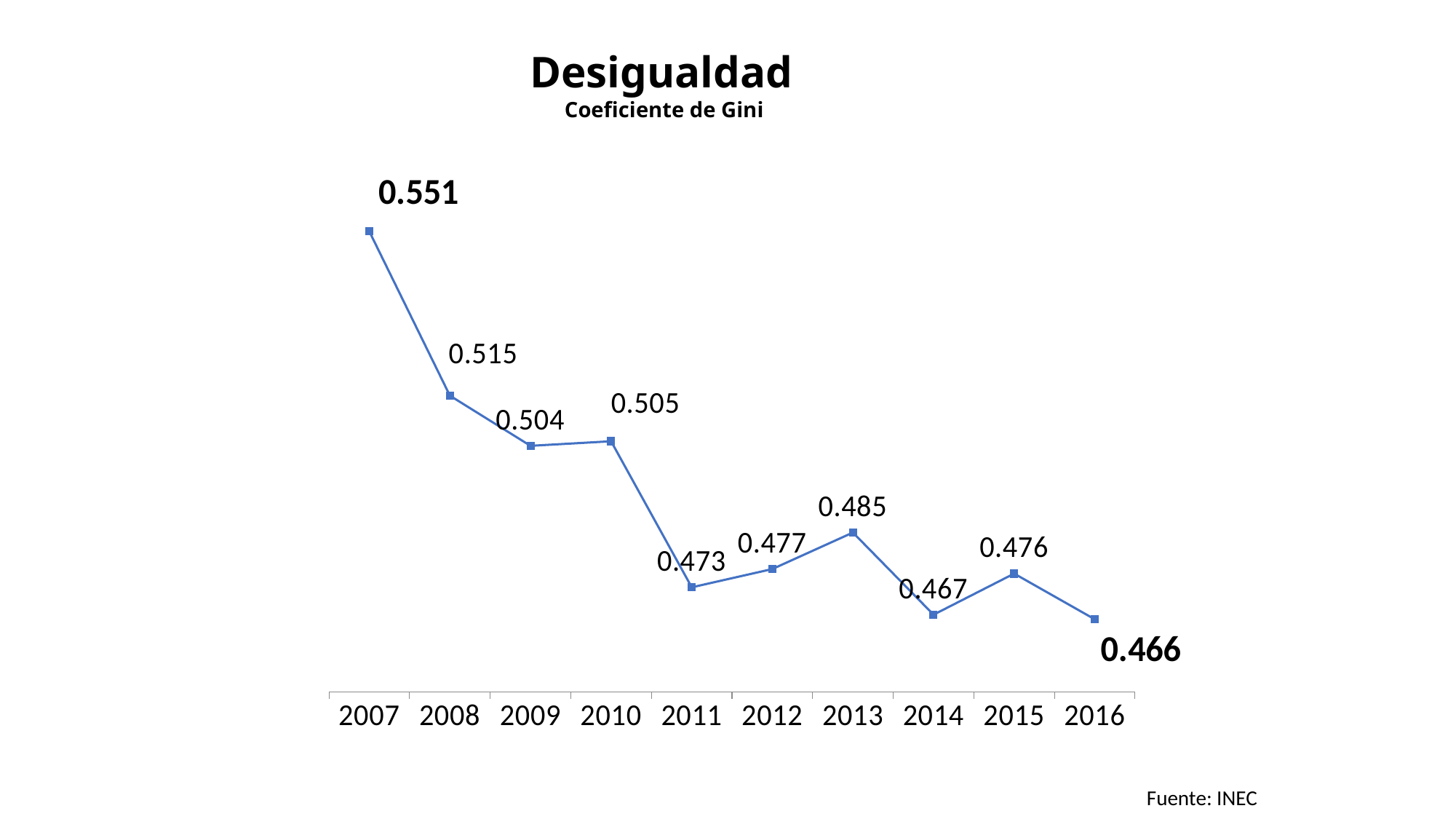
Which year has a higher Gini coefficient, 2008 or 2010? 2008 What is the Gini coefficient value for 2013? 0.485 What is the difference between the Gini coefficient in 2007 and in 2016? 0.085 What is the Gini coefficient value for 2011? 0.473 Which year has the lowest Gini coefficient? 2016 What kind of chart is shown on the slide? Line chart How many years are plotted on the chart? 10 What is the Gini coefficient value for 2007? 0.551 What is the Gini coefficient value for 2016? 0.466 Which year has the highest Gini coefficient? 2007 Does the Gini coefficient generally rise or fall from 2007 to 2016? Fall What is the title of the chart? Desigualdad